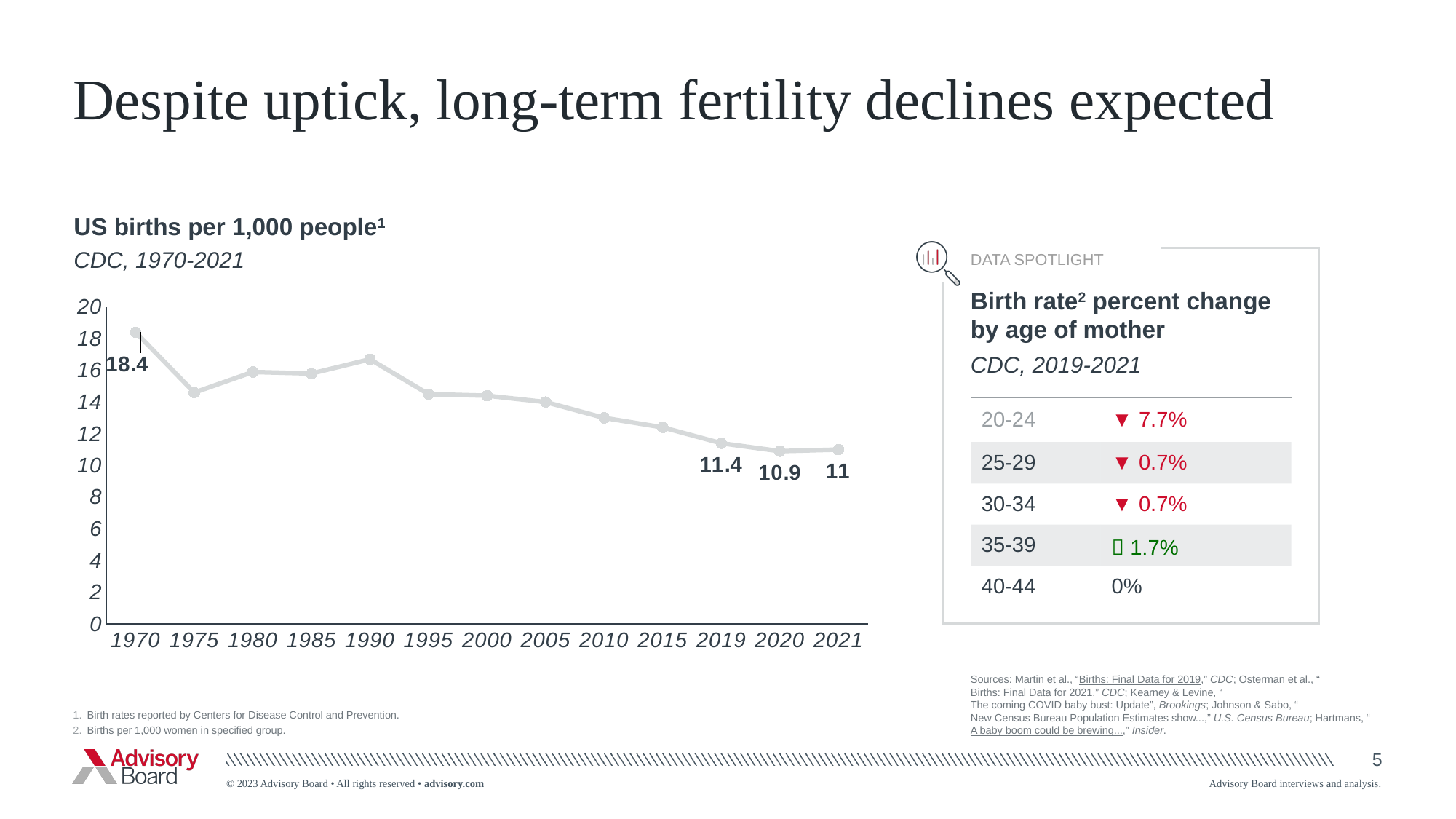
What type of chart is shown on the slide? Line chart What is the value of US births per 1,000 people in 2020? 10.9 What is the value of US births per 1,000 people in 2021? 11 Which year has a larger value of US births per 1,000 people, 2019 or 2021? 2019 Which year has the highest value of US births per 1,000 people? 1970 Is the value for 1990 greater or less than 16? greater What is the difference between the US births per 1,000 people in 2019 and in 2020? 0.5 What is the value of US births per 1,000 people in 1970? 18.4 What is the difference between the US births per 1,000 people in 1970 and in 2021? 7.4 Is the value for 2010 greater or less than 14? less Which year has the lowest value of US births per 1,000 people? 2020 How many years are plotted on the x axis of the chart? 13